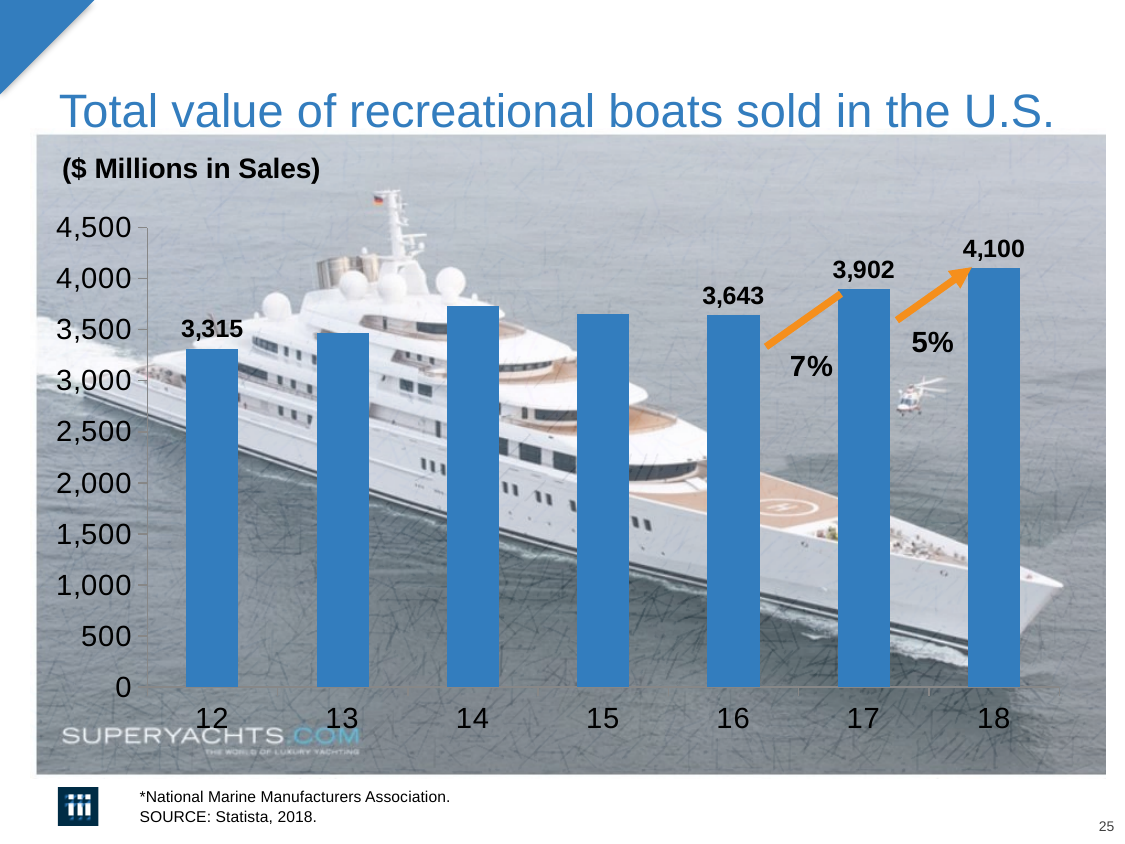
What kind of chart is shown? bar chart Which year has the lowest value? 12 What is the value for 18? 4,100 What is the difference between the values for 18 and 17? 198 Do the values rise or fall from 16 to 18? rise What is the value for 16? 3,643 Is the value for 14 greater or less than 3,500? greater Which year has the highest value? 18 What is the value for 17? 3,902 Which is larger, the value for 16 or the value for 17? 17 How many years are shown on the x axis? 7 What is the value for 12? 3,315